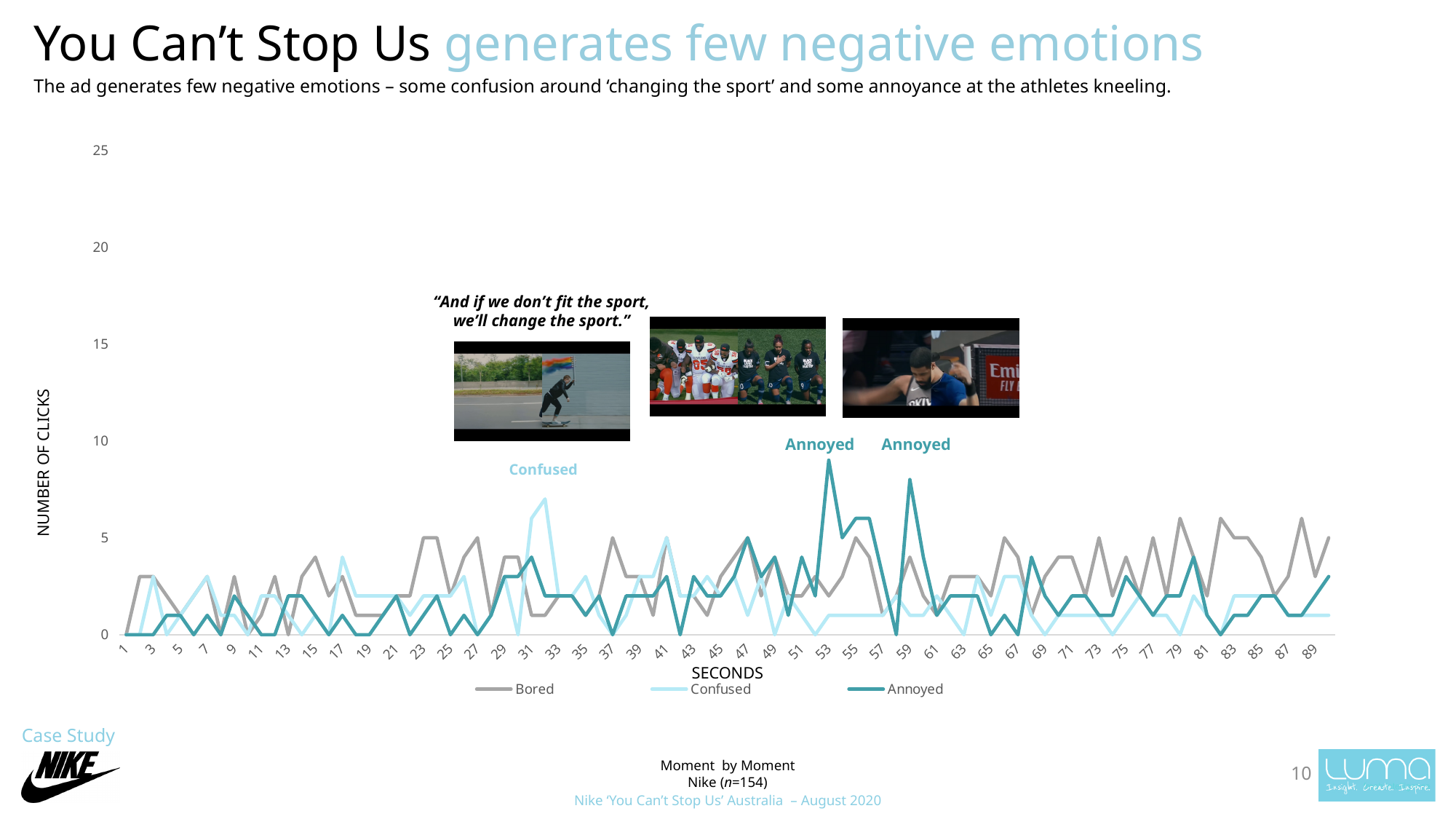
What are the three series named in the legend? Bored, Confused, Annoyed At second 53, which series has the larger value, Annoyed or Confused? Annoyed How many series does the legend list? 3 At second 32, which series has the larger value, Confused or Annoyed? Confused What kind of chart is shown on the slide? line chart What is the title of the vertical axis? NUMBER OF CLICKS Which series reaches the highest peak on the chart? Annoyed Is the peak value of the Annoyed series around second 59 greater or less than 10? less Is the peak value of the Annoyed series around second 53 greater or less than 5? greater Is the peak value of the Annoyed series around second 53 greater or less than 10? less